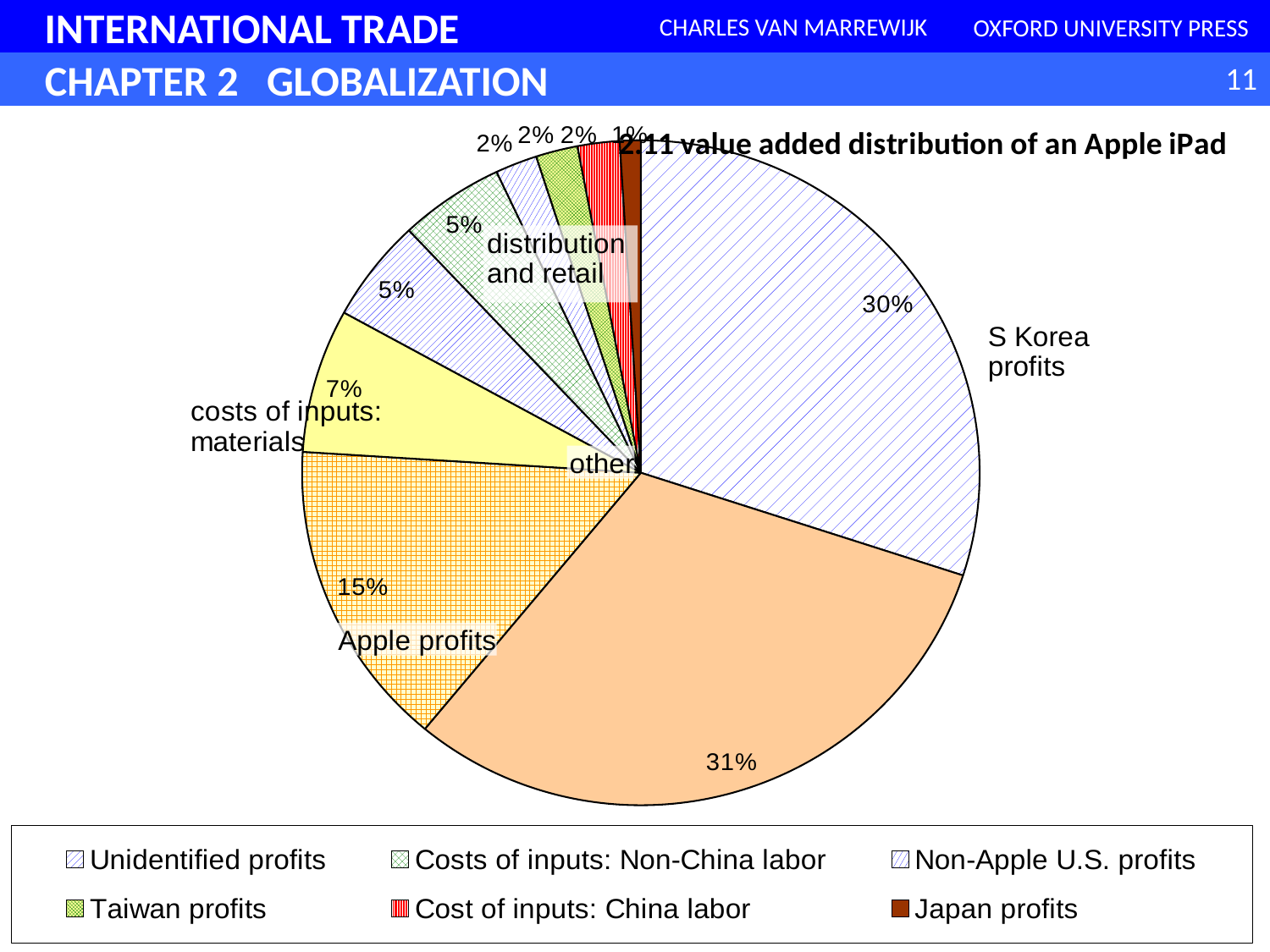
How many slices in the pie chart are labelled 5%? 2 Which is larger, the slice labelled 15% or the slice labelled 7%? 15% Which legend entry is shown with a solid dark brown fill? Japan profits What is the percentage of the largest slice in the pie chart? 31% What is the difference in percentage points between the 15% slice and the 7% slice? 8 What is the difference in percentage points between the 31% slice and the 30% slice? 1 What is the percentage of the smallest slice in the pie chart? 1% How many slices are labelled with percentages in the pie chart? 10 What kind of chart is shown on the slide? pie chart What is the title of the chart? 2.11 value added distribution of an Apple iPad How many slices in the pie chart are labelled 2%? 3 How many entries does the legend list? 6